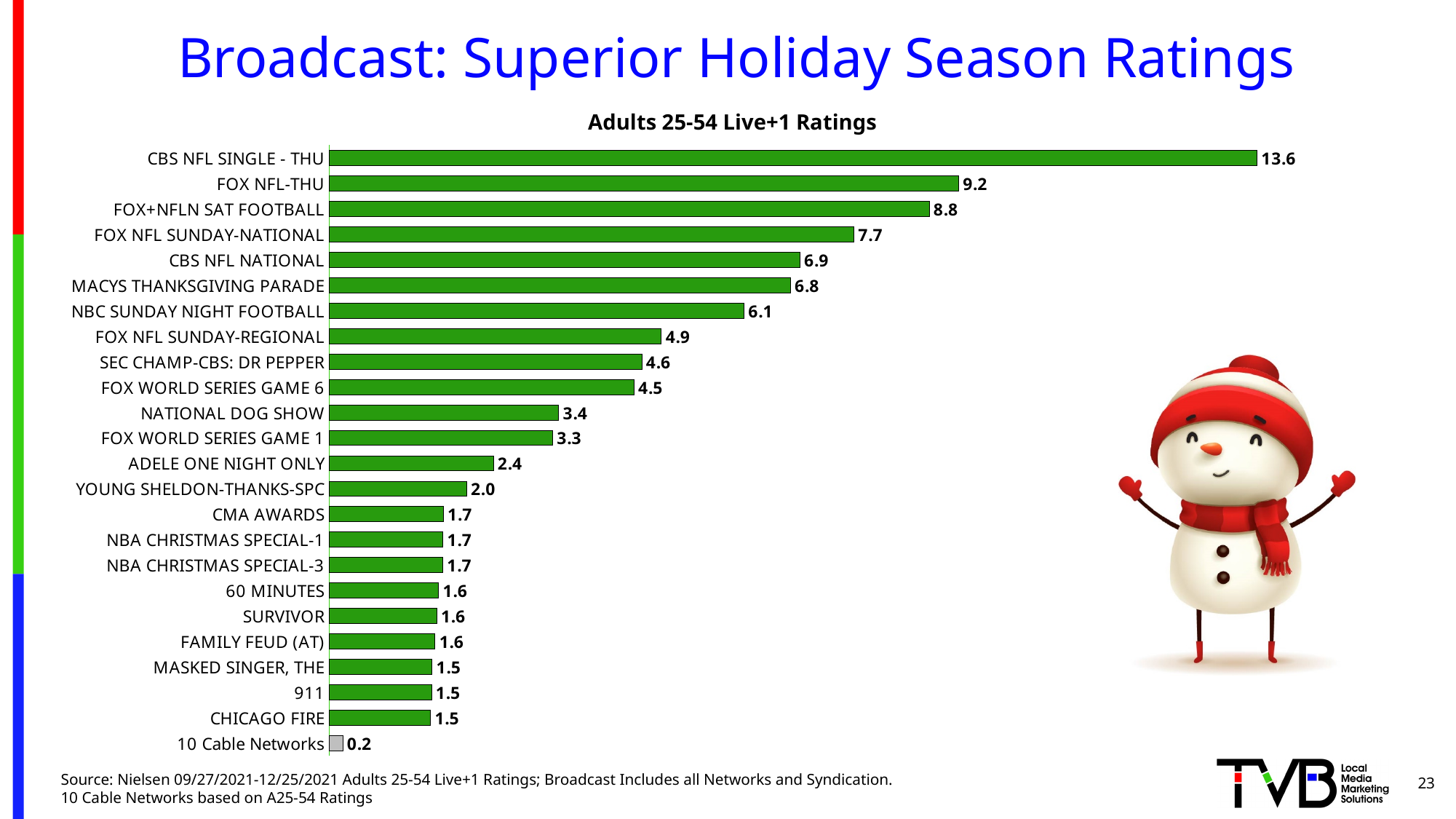
What is the difference between the ratings for FOX NFL-THU and FOX+NFLN SAT FOOTBALL? 0.4 What is the rating shown for 10 Cable Networks? 0.2 Which has a higher rating, NBC SUNDAY NIGHT FOOTBALL or FOX NFL SUNDAY-REGIONAL? NBC SUNDAY NIGHT FOOTBALL What is the rating shown for NATIONAL DOG SHOW? 3.4 Which category has the lowest rating on the chart? 10 Cable Networks What kind of chart is shown on the slide? Bar chart Which category has the highest rating on the chart? CBS NFL SINGLE - THU What is the Adults 25-54 Live+1 rating for CBS NFL SINGLE - THU? 13.6 How many categories are plotted on the chart? 24 What is the difference between the ratings for CBS NFL SINGLE - THU and 10 Cable Networks? 13.4 What is the title of the chart? Adults 25-54 Live+1 Ratings What is the rating shown for MACYS THANKSGIVING PARADE? 6.8